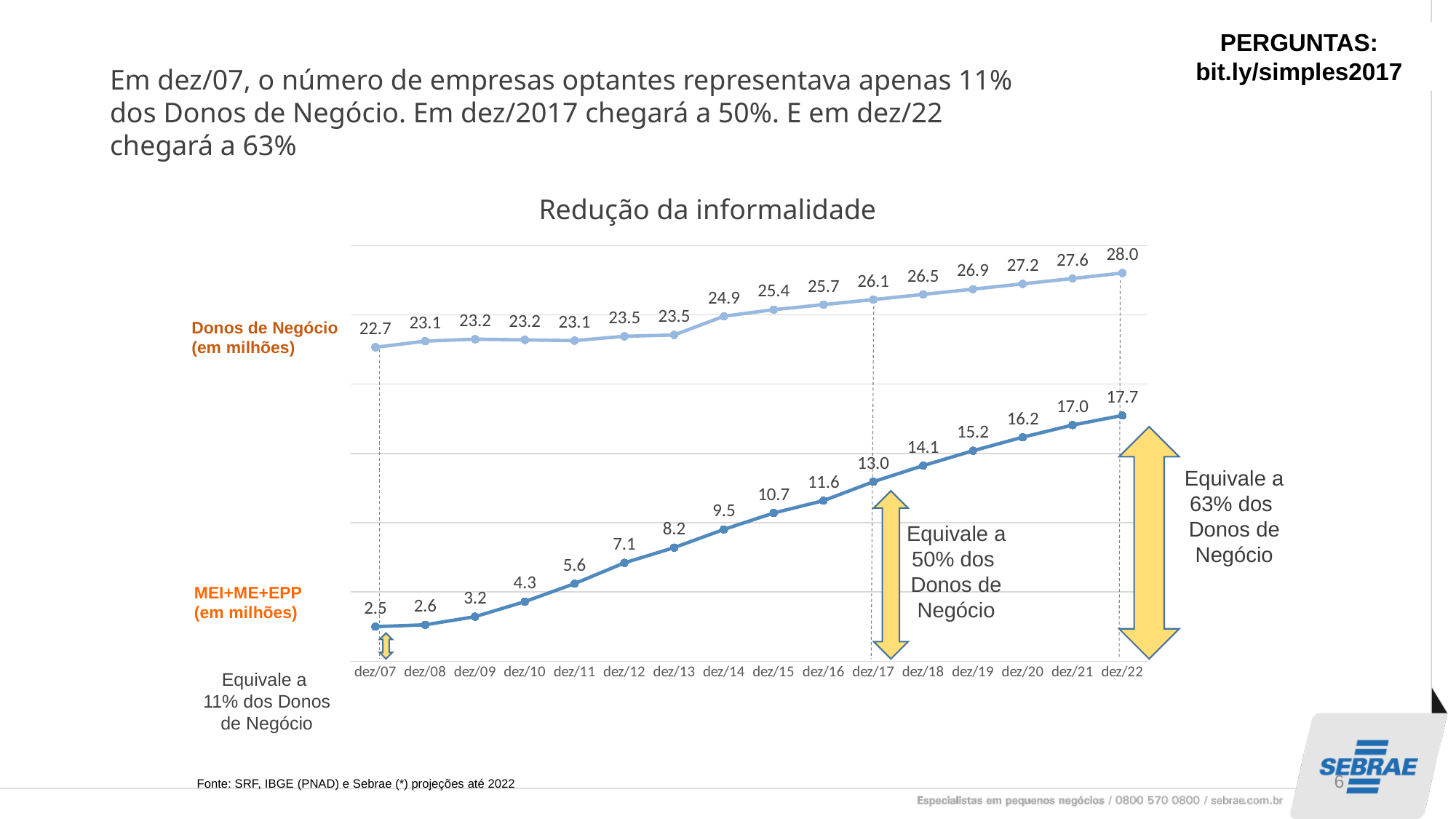
Does the MEI+ME+EPP (em milhões) line rise or fall from dez/07 to dez/22? rise What is the chart's title? Redução da informalidade What type of chart is shown on the slide? line chart What is the value of MEI+ME+EPP (em milhões) at dez/17? 13.0 What is the difference between MEI+ME+EPP (em milhões) at dez/22 and at dez/07? 15.2 What is the value of MEI+ME+EPP (em milhões) at dez/12? 7.1 In which period does MEI+ME+EPP (em milhões) reach its highest value? dez/22 Which is larger: Donos de Negócio at dez/14 or MEI+ME+EPP at dez/22? Donos de Negócio at dez/14 In which period does Donos de Negócio (em milhões) have its lowest value? dez/07 How many time periods are shown on the x axis? 16 What is the value of Donos de Negócio (em milhões) at dez/07? 22.7 What is the value of Donos de Negócio (em milhões) at dez/22? 28.0